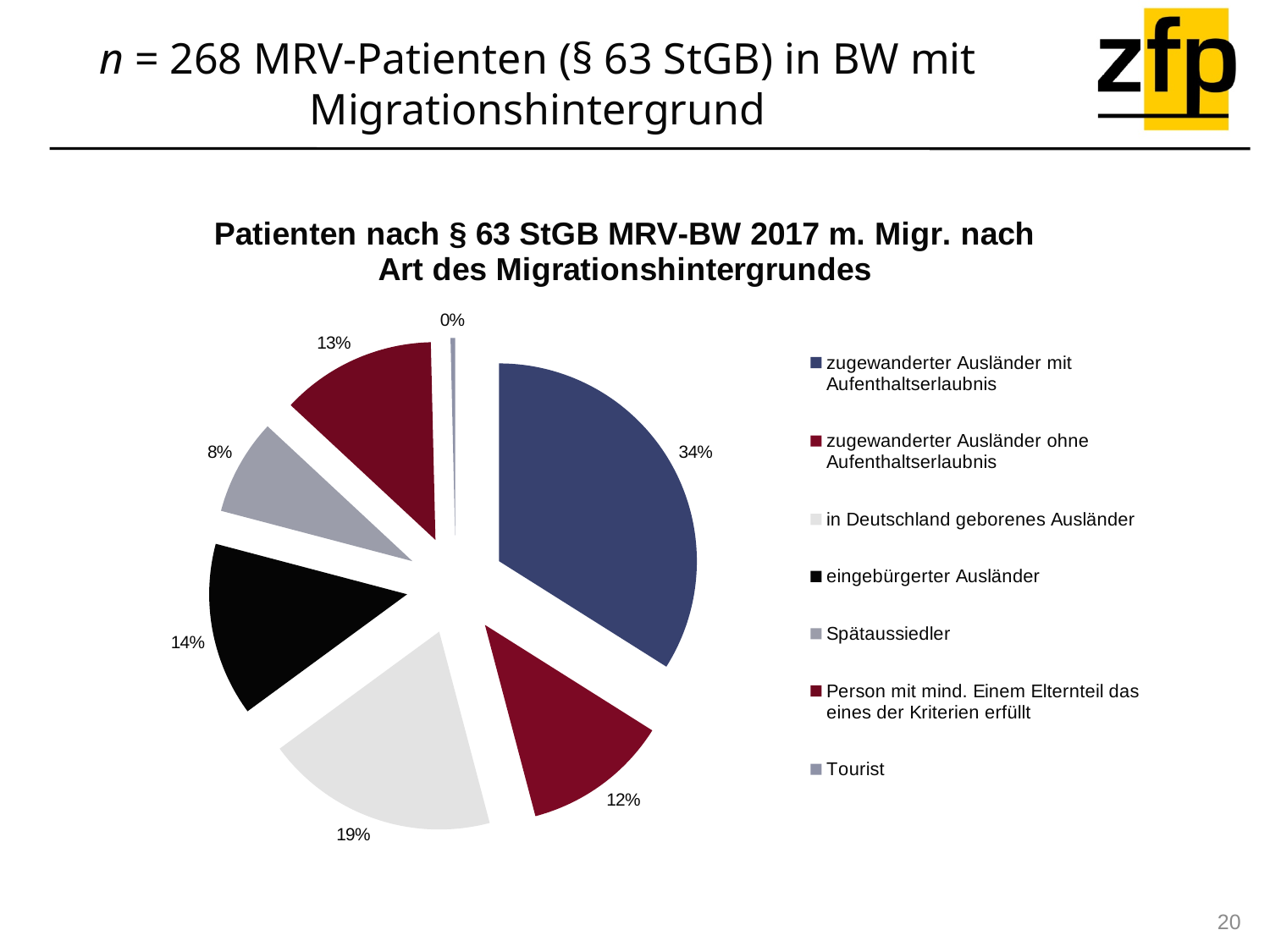
What is the difference in percentage points between 'zugewanderter Ausländer mit Aufenthaltserlaubnis' and 'in Deutschland geborenes Ausländer'? 15 percentage points What share of the pie is 'eingebürgerter Ausländer'? 14% Which category has the smallest share of the pie? Tourist How many categories does the legend list? 7 What is the title of the chart? Patienten nach § 63 StGB MRV-BW 2017 m. Migr. nach Art des Migrationshintergrundes Which category has the largest share of the pie? zugewanderter Ausländer mit Aufenthaltserlaubnis What share of the pie is 'Tourist'? 0% What share of the pie is 'zugewanderter Ausländer mit Aufenthaltserlaubnis'? 34% Which is larger: the share for 'eingebürgerter Ausländer' or the share for 'Spätaussiedler'? eingebürgerter Ausländer What kind of chart is shown on the slide? pie chart